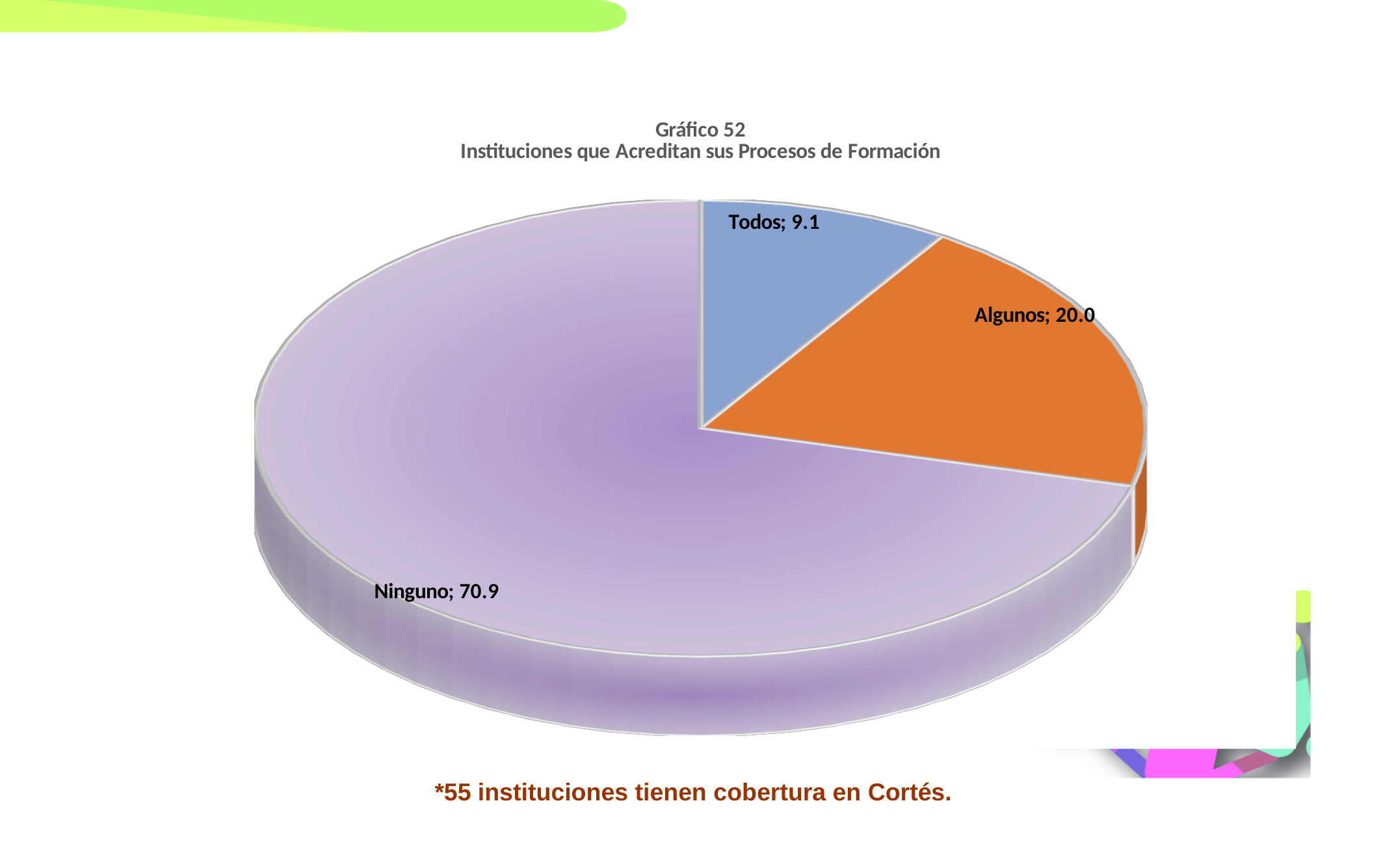
What value is shown for the Todos slice? 9.1 Which category has the largest slice of the pie? Ninguno What value is shown for the Ninguno slice? 70.9 What is the title of the chart? Gráfico 52 Instituciones que Acreditan sus Procesos de Formación How many slices does the pie chart have? 3 Which category has the smallest slice of the pie? Todos Which is larger, the value for Algunos or the value for Todos? Algunos What value is shown for the Algunos slice? 20.0 What kind of chart is shown on the slide? Pie chart What is the difference between the values for Ninguno and Algunos? 50.9 What is the difference between the values for Algunos and Todos? 10.9 What colour is the Algunos slice? Orange